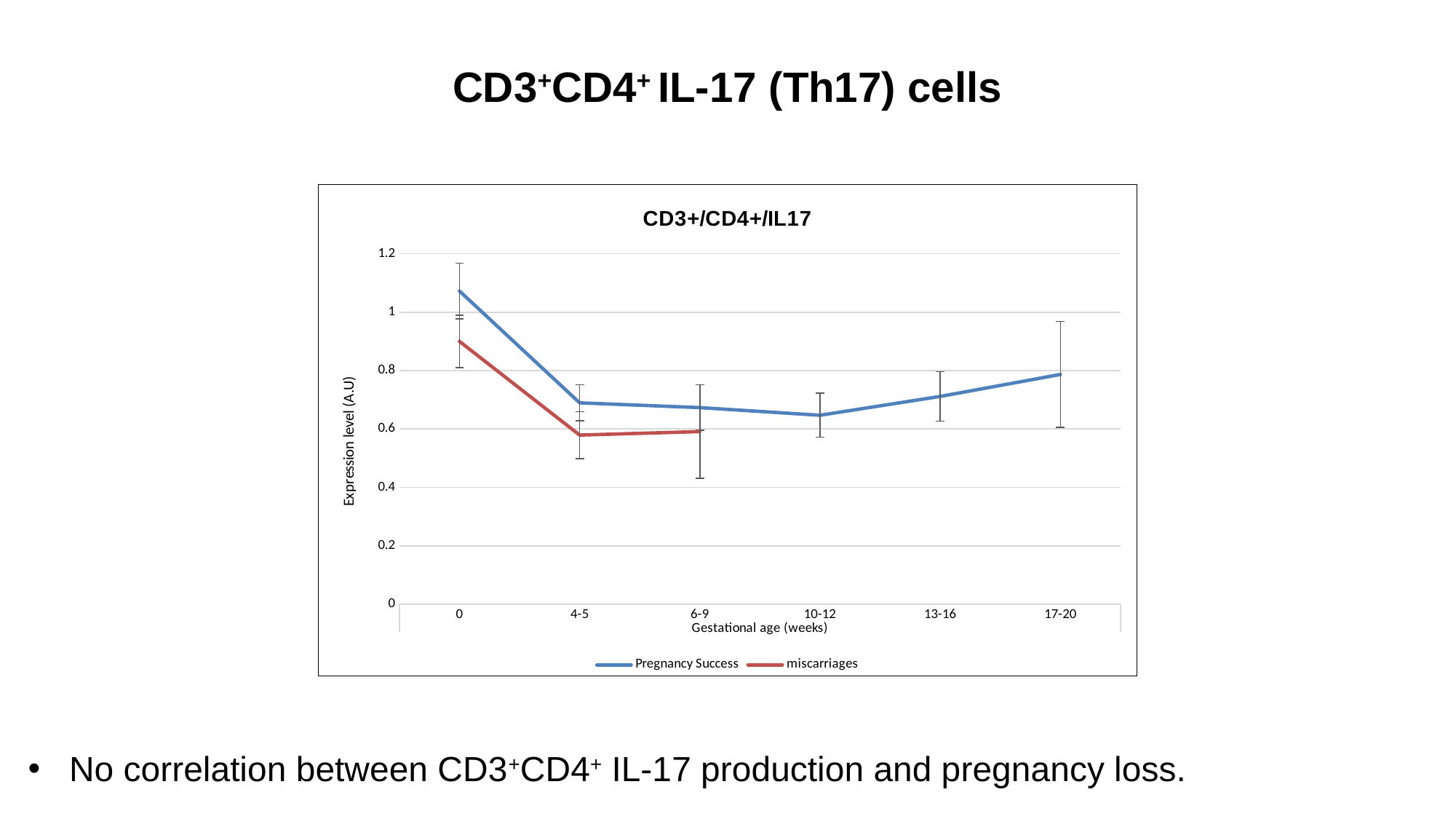
What kind of chart is shown on the slide? line chart How many series does the legend list? 2 What is the label of the y axis? Expression level (A.U) Is the value for miscarriages at gestational age 0 greater or less than 1? less At which gestational age is the Pregnancy Success series highest? 0 Is the value for Pregnancy Success at gestational age 4-5 greater or less than 0.6? greater Does the Pregnancy Success series rise or fall from gestational age 0 to 4-5? fall Is the value for Pregnancy Success at gestational age 0 greater or less than 1? greater How many data points does the miscarriages series have? 3 At gestational age 4-5, which series has the higher value, Pregnancy Success or miscarriages? Pregnancy Success At which gestational age is the miscarriages series highest? 0 How many gestational age categories are shown on the x axis? 6